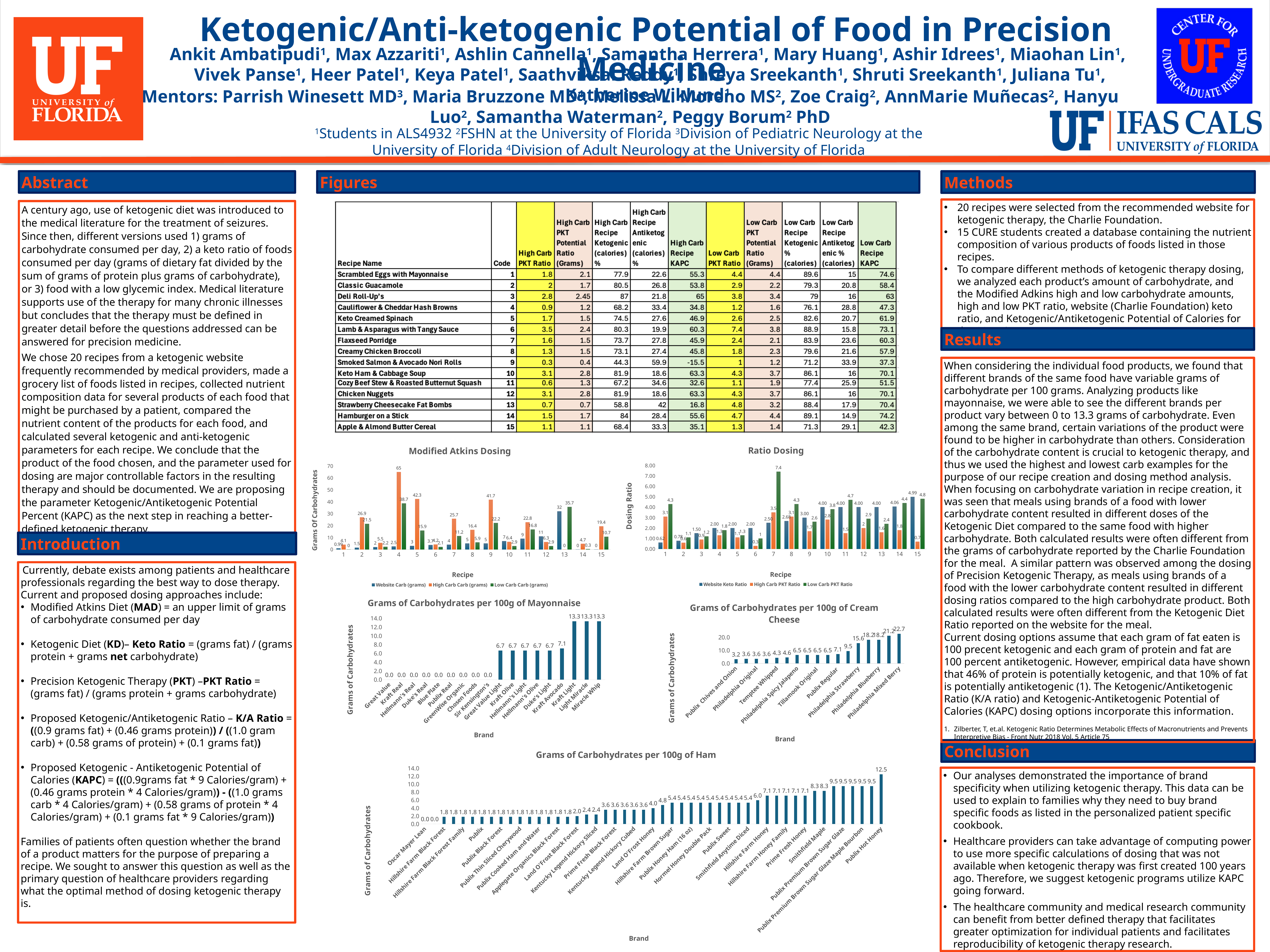
In the Modified Atkins Dosing chart, what is the High Carb Carb (grams) value for recipe 4? 65 In the Grams of Carbohydrates per 100g of Mayonnaise chart, what is the value for Kraft Avocado? 7.1 In the Modified Atkins Dosing chart, what is the difference between the High Carb Carb (grams) and Low Carb Carb (grams) values for recipe 5? 26.4 In the Ratio Dosing chart, how many recipes are shown on the x axis? 15 In the Ratio Dosing chart, what is the Low Carb PKT Ratio for recipe 7? 7.4 In the Grams of Carbohydrates per 100g of Ham chart, which brand has the highest value? Publix Hot Honey In the Modified Atkins Dosing chart, how many series does the legend list? 3 In the Grams of Carbohydrates per 100g of Mayonnaise chart, what is the value for Miracle Whip? 13.3 In the Grams of Carbohydrates per 100g of Cream Cheese chart, what is the value for Publix Chives and Onion? 3.2 What kind of chart is the Grams of Carbohydrates per 100g of Mayonnaise chart? bar chart In the Modified Atkins Dosing chart, which recipe number has the highest High Carb Carb (grams) value? 4 In the Grams of Carbohydrates per 100g of Cream Cheese chart, which brand has the highest value? Philadelphia Mixed Berry